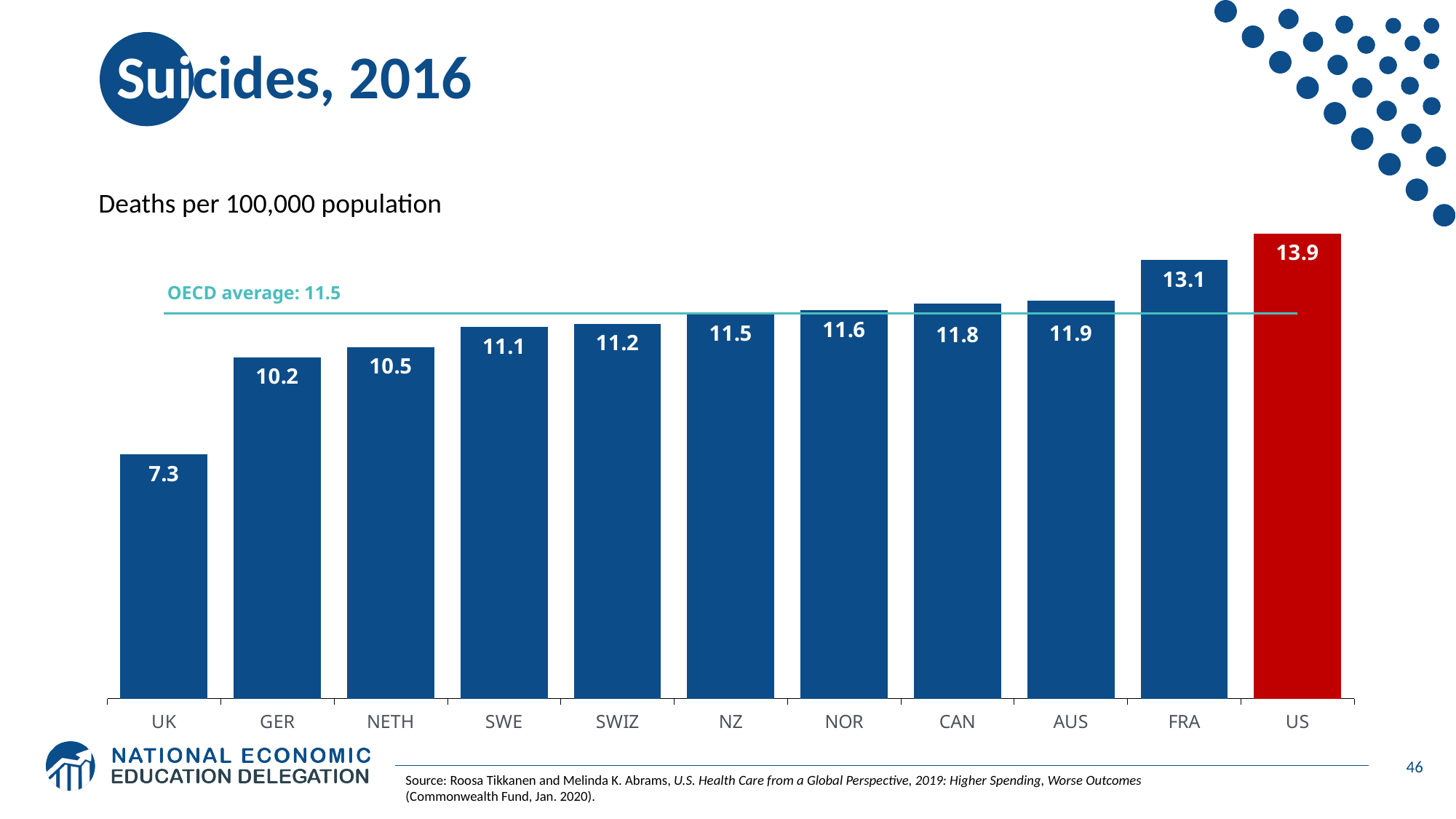
Which country has the highest value? US How many countries are shown in the chart? 11 Which is larger, the value for SWE or the value for CAN? CAN Which country has the lowest value? UK What is the difference between the values for FRA and AUS? 1.2 What is the difference between the values for the US and the UK? 6.6 What is the value for NOR? 11.6 Do the values rise or fall from left to right along the x axis? rise What OECD average value is marked by the horizontal line on the chart? 11.5 What is the value for GER? 10.2 What is the value for the US? 13.9 What kind of chart is this? bar chart